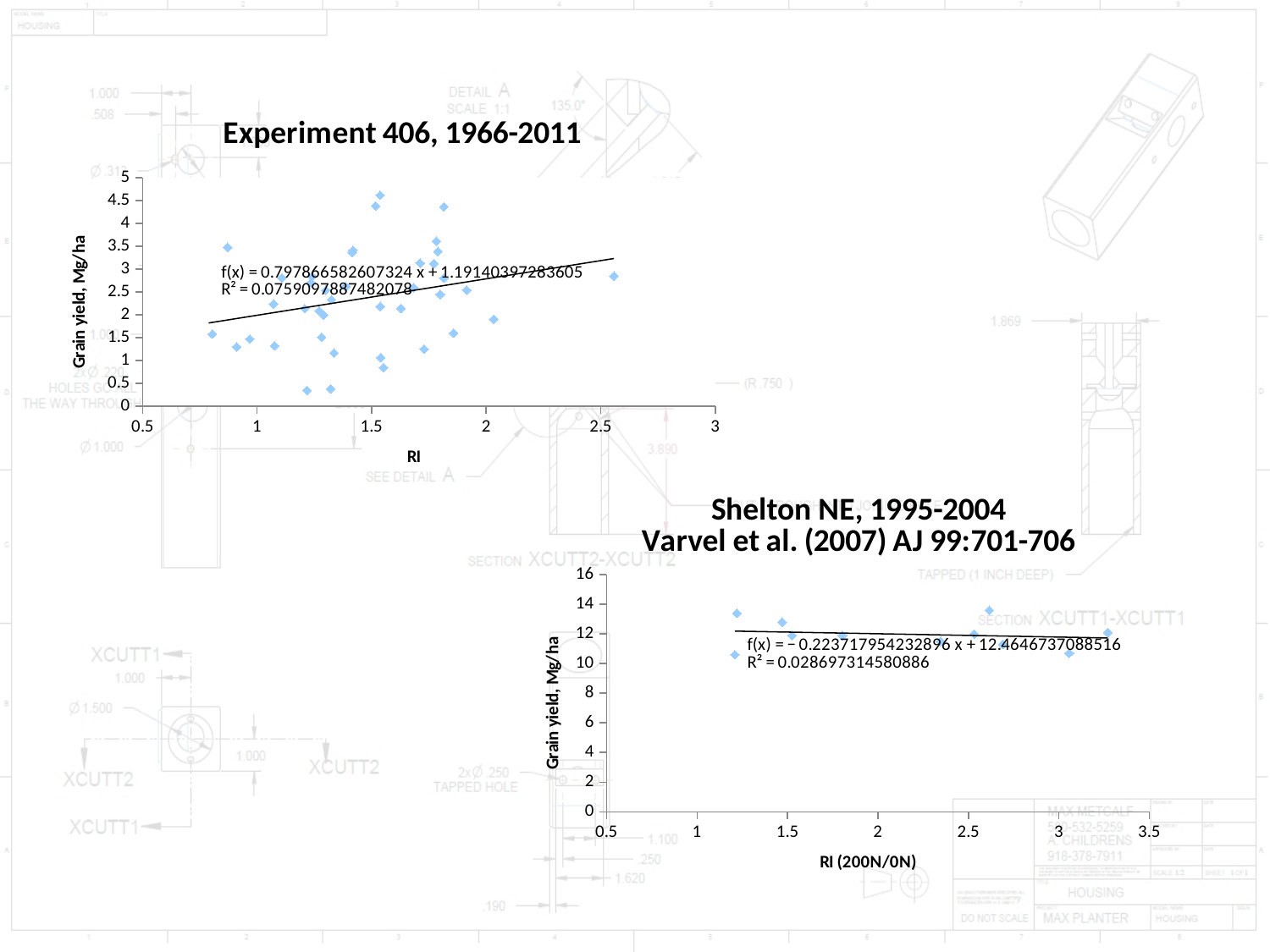
What is the x-axis label of the 'Shelton NE, 1995-2004' chart? RI (200N/0N) What kind of chart is the 'Shelton NE, 1995-2004' chart? scatter chart What kind of chart is the 'Experiment 406, 1966-2011' chart? scatter chart In the 'Experiment 406, 1966-2011' chart, does the trendline rise or fall as RI increases? rise In the 'Experiment 406, 1966-2011' chart, what is the R² value shown for the trendline? 0.0759097887482078 In the 'Shelton NE, 1995-2004' chart, does the trendline rise or fall as RI increases? fall In the 'Experiment 406, 1966-2011' chart, is the grain yield of the lowest point greater or less than 1 Mg/ha? less What is the y-axis label of the 'Experiment 406, 1966-2011' chart? Grain yield, Mg/ha In the 'Experiment 406, 1966-2011' chart, what is the trendline equation shown? f(x) = 0.797866582607324 x + 1.19140397283605 In the 'Experiment 406, 1966-2011' chart, is the grain yield of the highest point greater or less than 4 Mg/ha? greater In the 'Shelton NE, 1995-2004' chart, what is the trendline equation shown? f(x) = − 0.223717954232896 x + 12.4646737088516 In the 'Shelton NE, 1995-2004' chart, what is the R² value shown for the trendline? 0.028697314580886